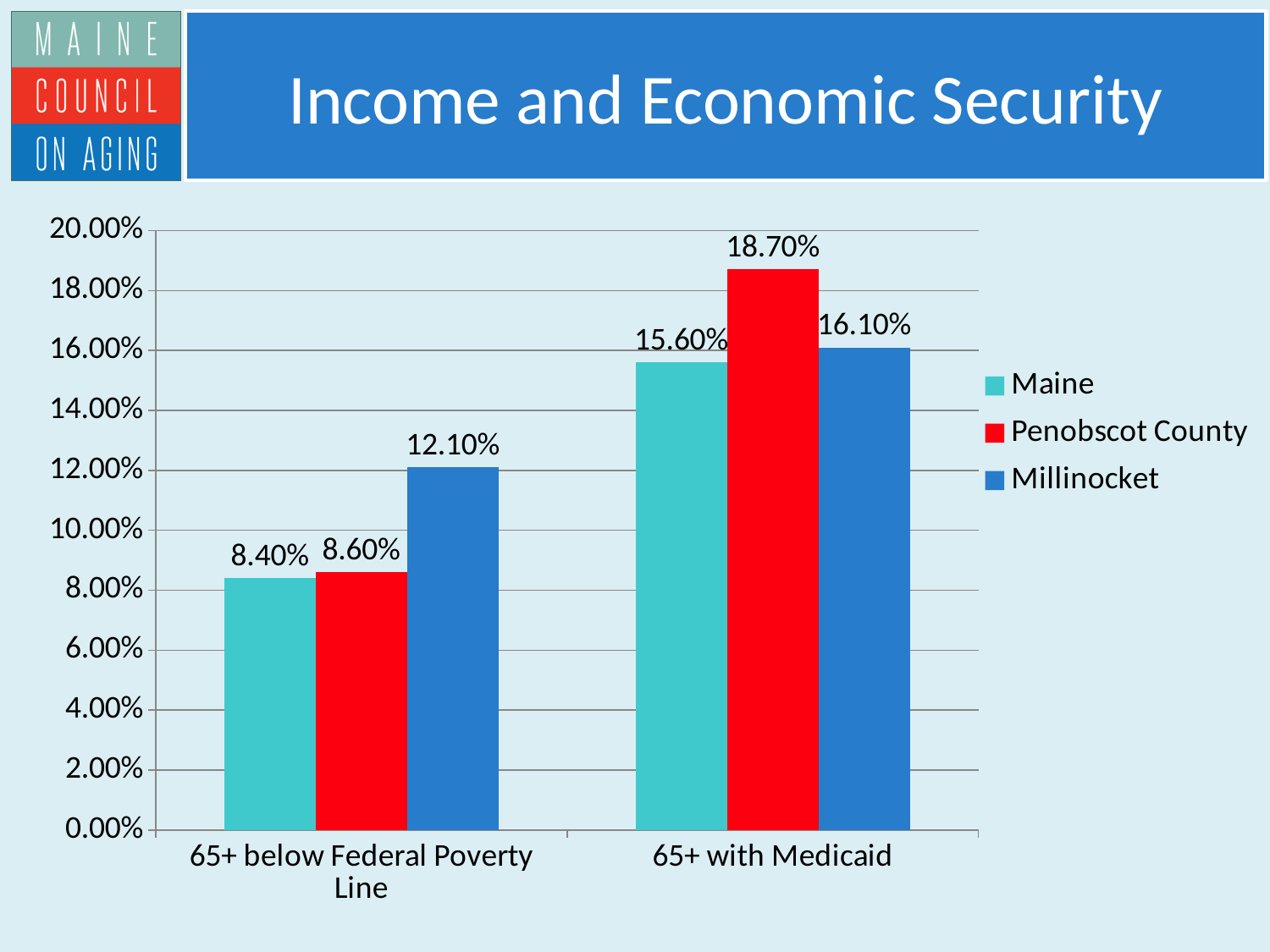
How many series does the legend list? 3 Which series has the highest value in the '65+ with Medicaid' category? Penobscot County What is the difference between Penobscot County and Millinocket in the '65+ with Medicaid' category? 2.60% How many categories are shown on the x axis? 2 Which series has the lowest value in the '65+ below Federal Poverty Line' category? Maine What is the value for Millinocket in the '65+ below Federal Poverty Line' category? 12.10% What is the difference between Millinocket and Maine in the '65+ below Federal Poverty Line' category? 3.70% Which is larger: Millinocket's value for '65+ with Medicaid' or Maine's value for '65+ with Medicaid'? Millinocket What kind of chart is shown on the slide? Bar chart What is the value for Maine in the '65+ below Federal Poverty Line' category? 8.40% What is the value for Penobscot County in the '65+ with Medicaid' category? 18.70% What is the value for Maine in the '65+ with Medicaid' category? 15.60%